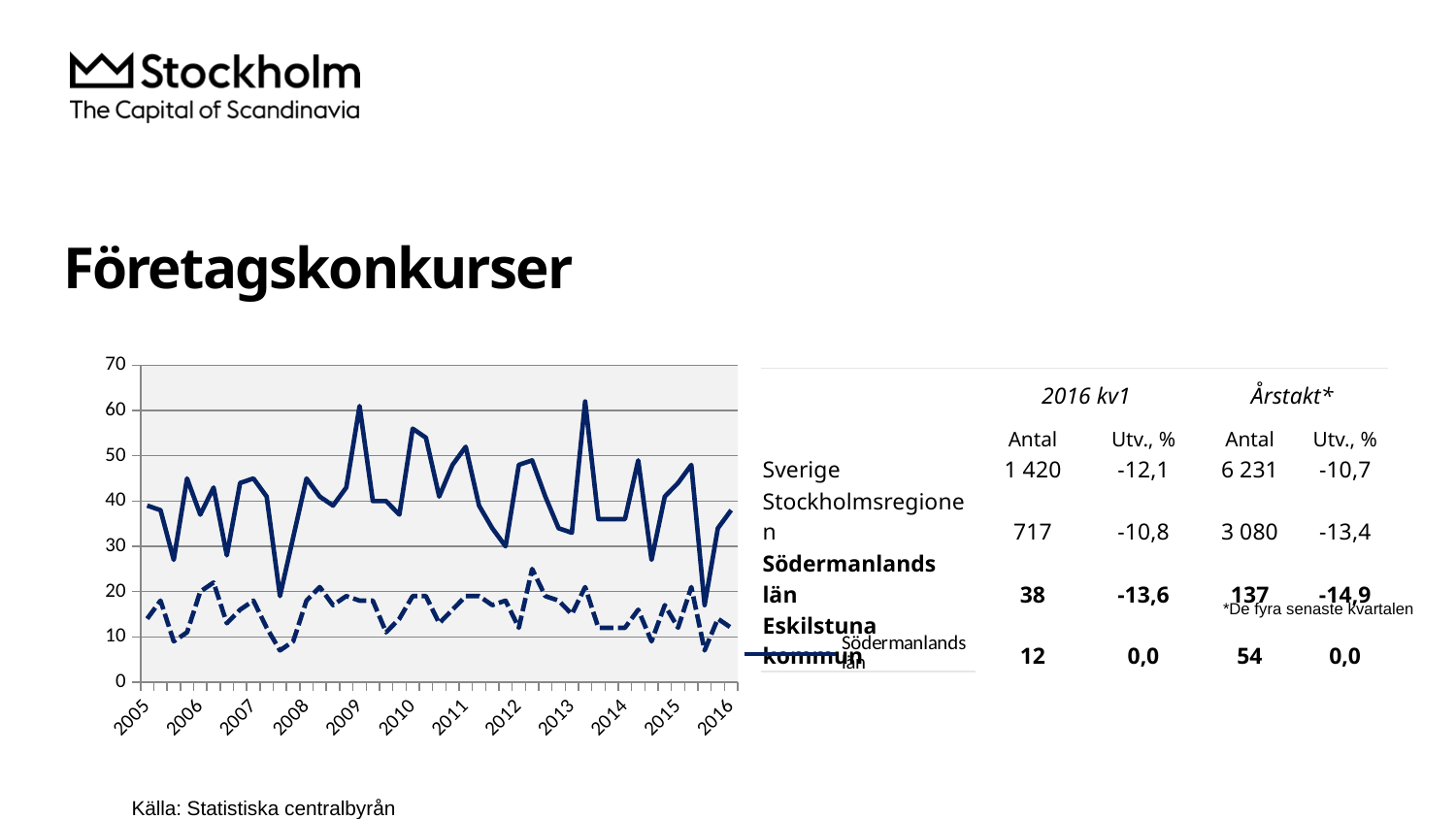
Is the lowest point of the dashed line in the chart greater or less than 10? less Is the value of the solid line at the start of 2005 greater or less than 30? greater What is the last year shown on the x axis of the chart? 2016 How many year labels are shown on the x axis of the chart? 12 What is the highest value shown on the y axis of the chart? 70 What kind of chart is shown on the slide? line chart Which series name is readable in the chart's legend? Södermanlands län What is the title of the slide containing the chart? Företagskonkurser Is the highest point of the dashed line in the chart greater or less than 30? less Which line in the chart has higher values throughout the period, the solid line or the dashed line? the solid line What is the first year shown on the x axis of the chart? 2005